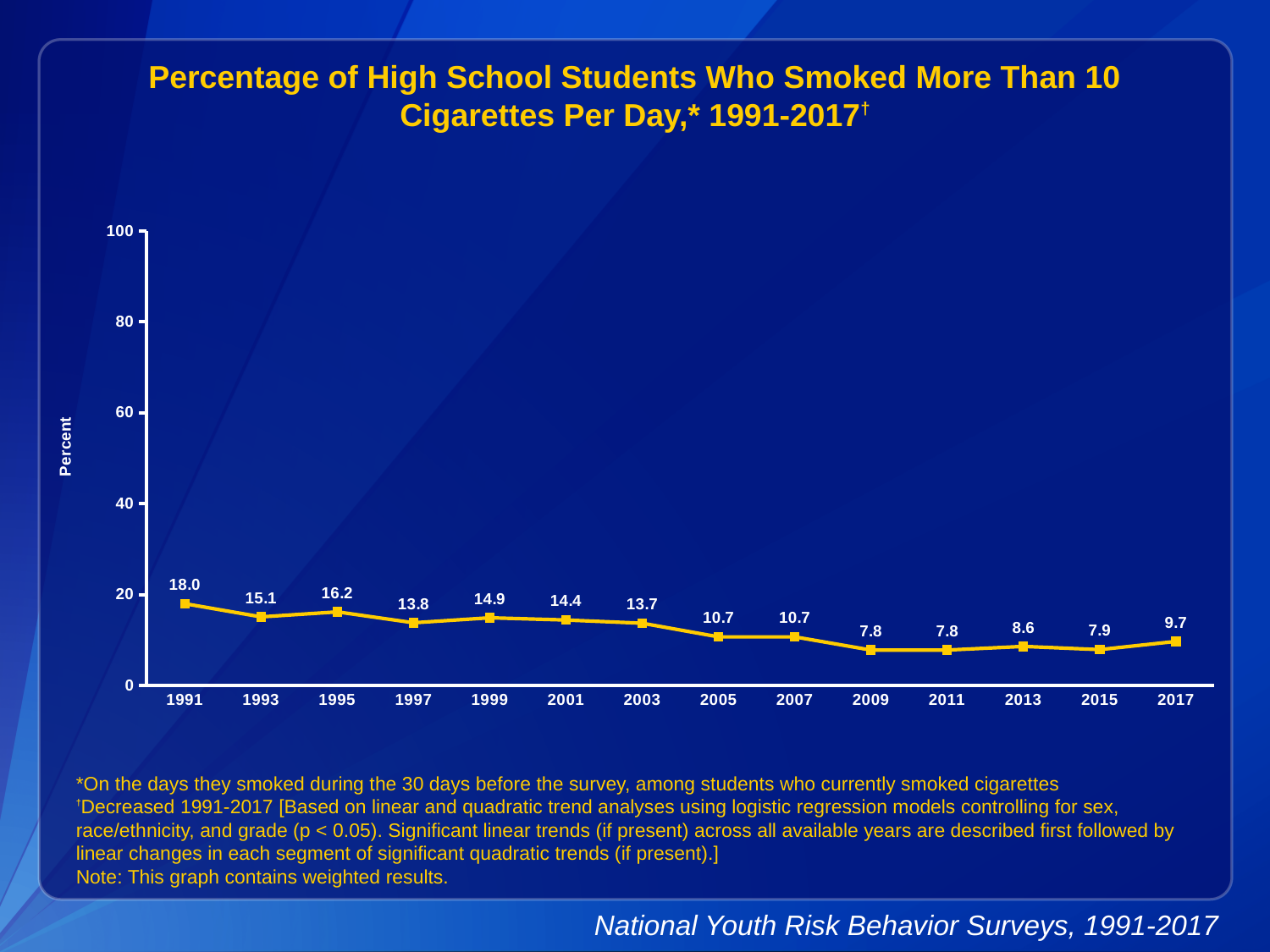
What value is shown for 2017? 9.7 What is the lowest value shown on the chart? 7.8 Do the values generally rise or fall from 1991 to 2017? Fall Which year has the highest value on the chart? 1991 What kind of chart is shown on the slide? Line chart What is the difference between the values for 1991 and 2017? 8.3 What value is shown for 2003? 13.7 What was the percentage of high school students who smoked more than 10 cigarettes per day in 1991? 18.0 Is the value for 2009 greater or less than 20? less What is the label on the y axis? Percent How many years are plotted on the x axis? 14 Which year has the larger value, 1995 or 1997? 1995